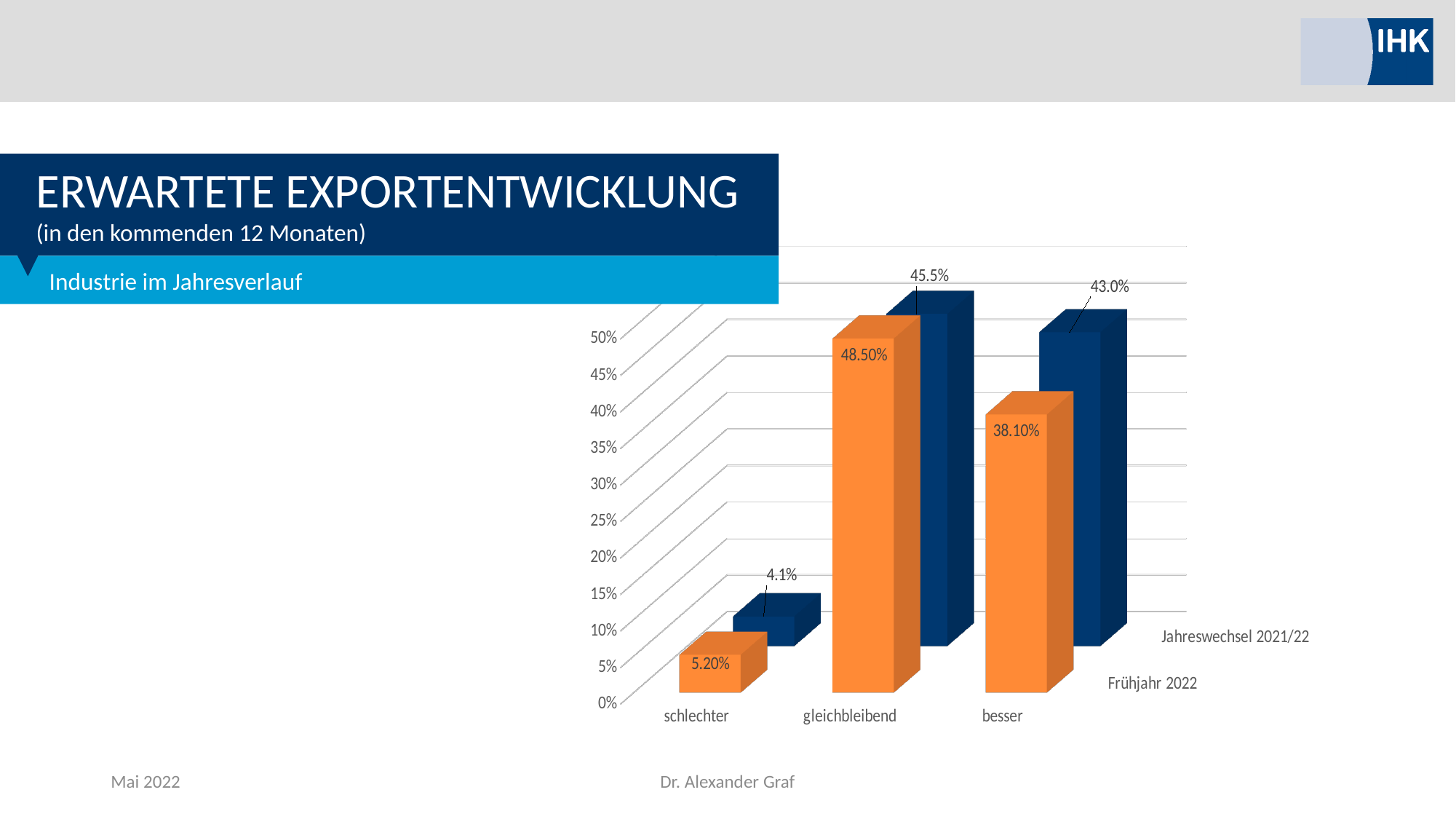
What is the value for "besser" in the Jahreswechsel 2021/22 series? 43.0% What is the value for "schlechter" in the Jahreswechsel 2021/22 series? 4.1% For "gleichbleibend", which series has the larger value, Frühjahr 2022 or Jahreswechsel 2021/22? Frühjahr 2022 What is the difference between the Frühjahr 2022 and Jahreswechsel 2021/22 values for "besser"? 4.9 percentage points What is the value for "gleichbleibend" in the Frühjahr 2022 series? 48.50% Which category has the highest value in the Frühjahr 2022 series? gleichbleibend How many categories are shown on the x axis? 3 What kind of chart is shown on the slide? Bar chart Which category has the lowest value in the Jahreswechsel 2021/22 series? schlechter How many series does the chart show? 2 Which colour represents the Jahreswechsel 2021/22 series? Dark blue What is the value for "schlechter" in the Frühjahr 2022 series? 5.20%